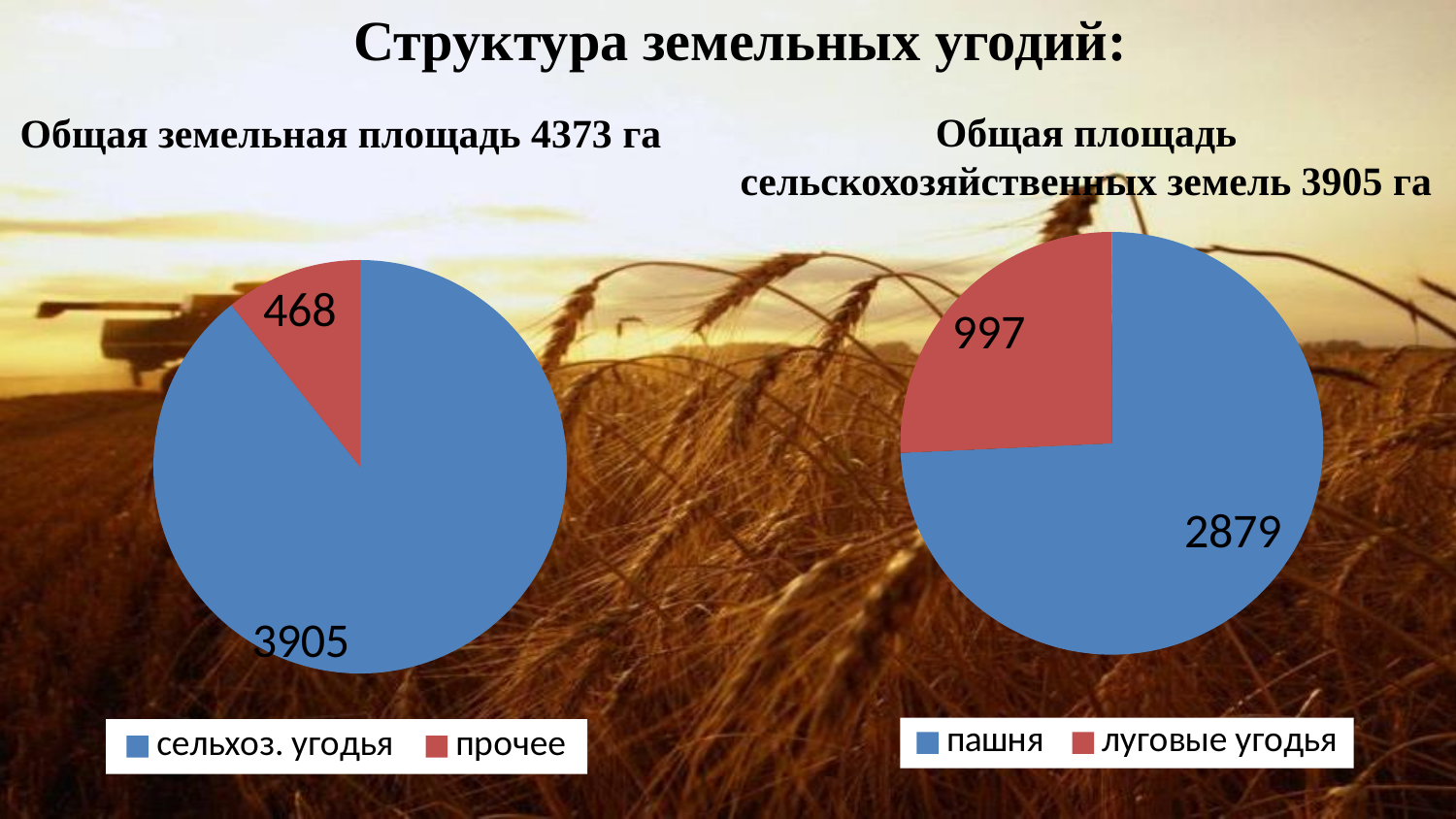
In the left pie chart, which category has the largest slice? сельхоз. угодья In the left pie chart (Общая земельная площадь 4373 га), what is the value for прочее? 468 In the left pie chart, what is the difference between сельхоз. угодья and прочее? 3437 In the right pie chart, which category has the smallest slice? луговые угодья In the right pie chart, which is larger: пашня or луговые угодья? пашня How many slices does the left pie chart have? 2 In the right pie chart (Общая площадь сельскохозяйственных земель 3905 га), what is the value for пашня? 2879 In the left pie chart (Общая земельная площадь 4373 га), what is the value for сельхоз. угодья? 3905 In the right pie chart (Общая площадь сельскохозяйственных земель 3905 га), what is the value for луговые угодья? 997 What type of chart is used on the right side of the slide? pie chart What colour is the луговые угодья slice in the right pie chart? red In the right pie chart, what is the difference between пашня and луговые угодья? 1882